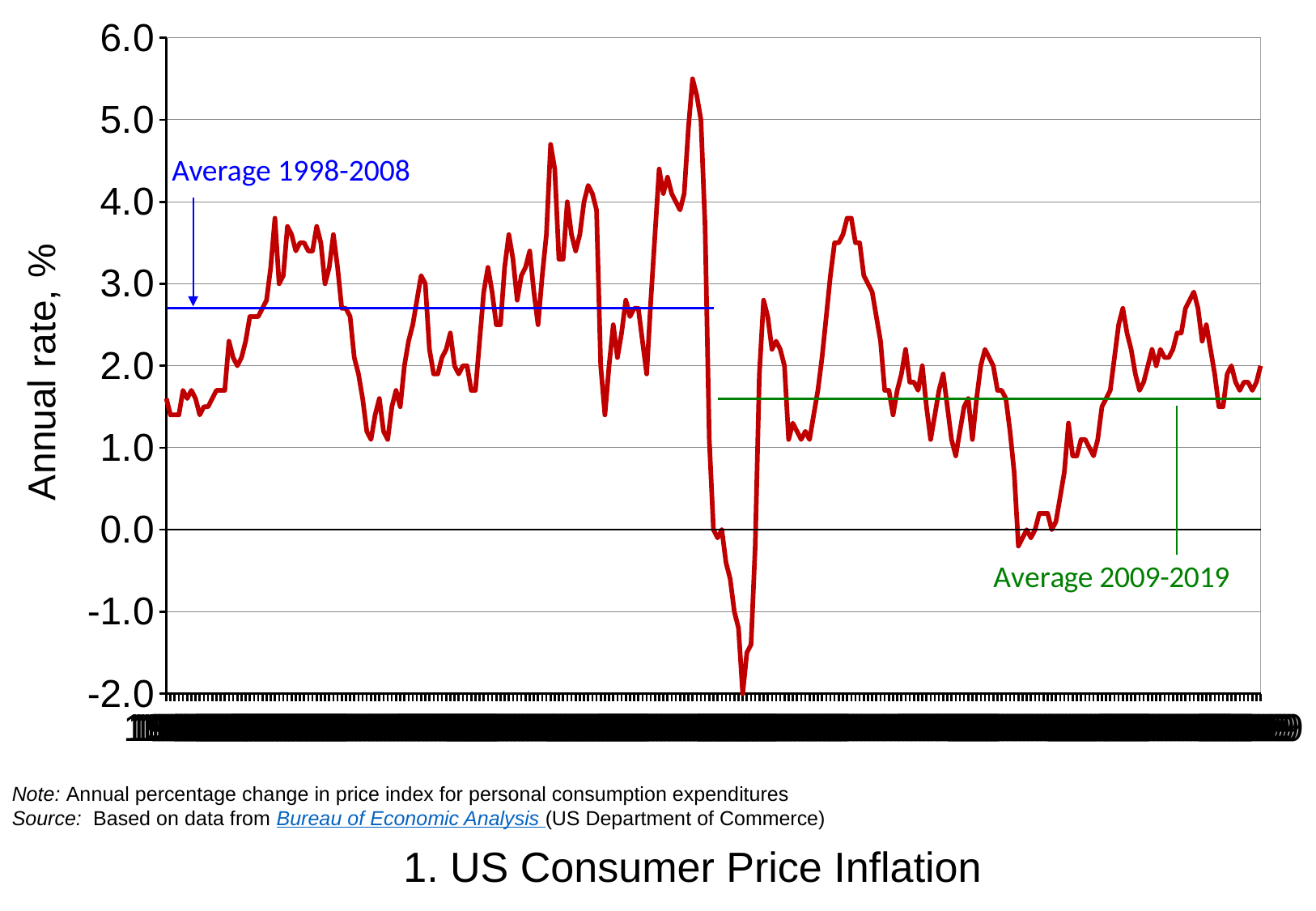
Is the Average 1998-2008 line greater or less than 2.0? greater What is the lowest value shown on the vertical axis? -2.0 Which average line is higher, Average 1998-2008 or Average 2009-2019? Average 1998-2008 Is the Average 2009-2019 line greater or less than 2.0? less Is the highest point of the inflation line greater or less than 5.0? greater What is the highest value shown on the vertical axis? 6.0 What kind of chart is shown on the slide? line chart What is the label on the vertical axis of the chart? Annual rate, %